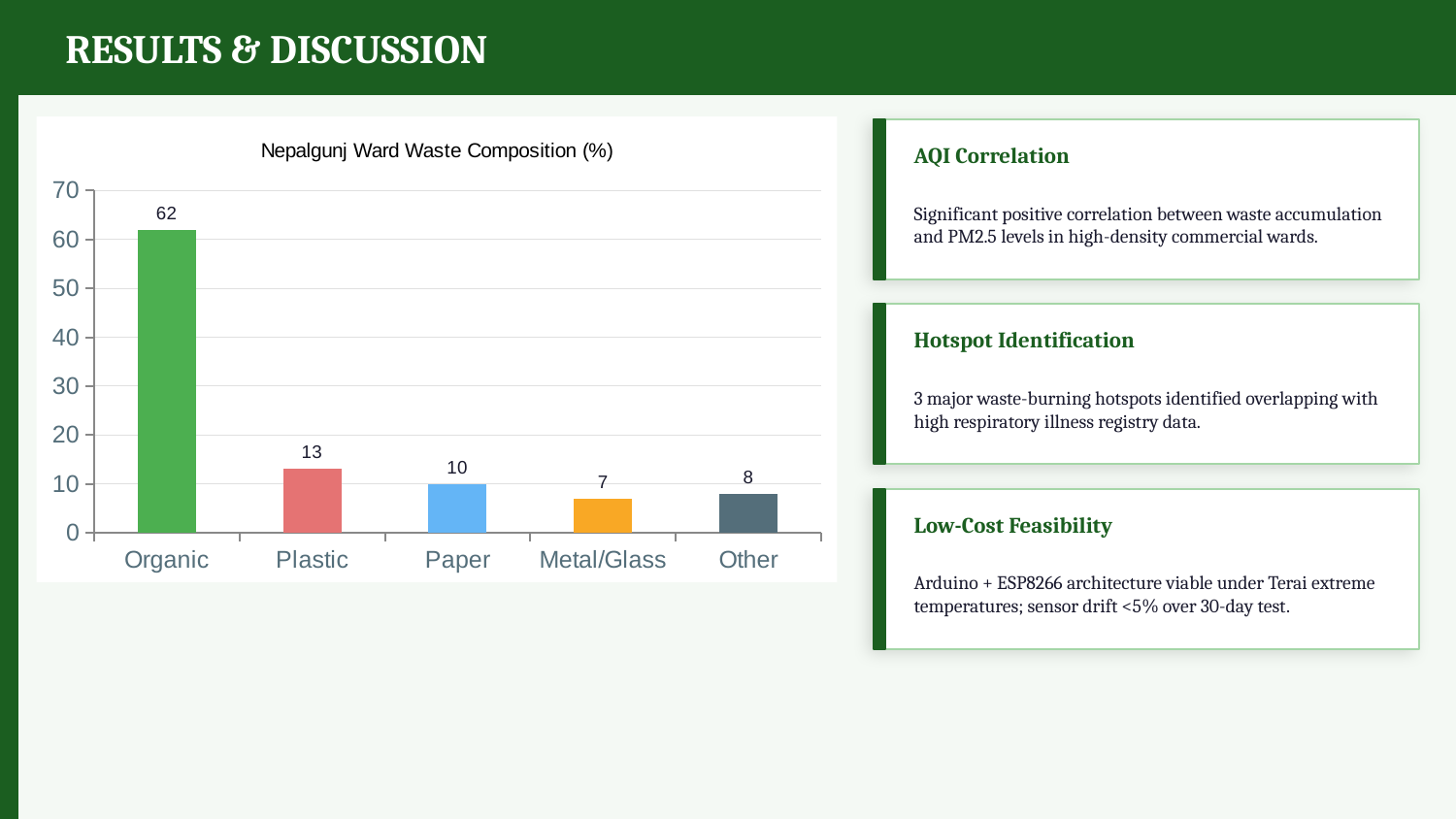
What is the value for Metal/Glass? 7 Which is larger, the value for Paper or the value for Other? Paper How many categories are shown on the x axis? 5 What kind of chart is shown on the slide? Bar chart What is the value for Plastic? 13 Which category has the highest value? Organic What is the value for Other? 8 What is the difference between the values for Organic and Plastic? 49 What is the title of the chart? Nepalgunj Ward Waste Composition (%) Which category has the lowest value? Metal/Glass Is the value for Organic greater or less than 60? greater What is the value for Organic in the Nepalgunj Ward Waste Composition chart? 62